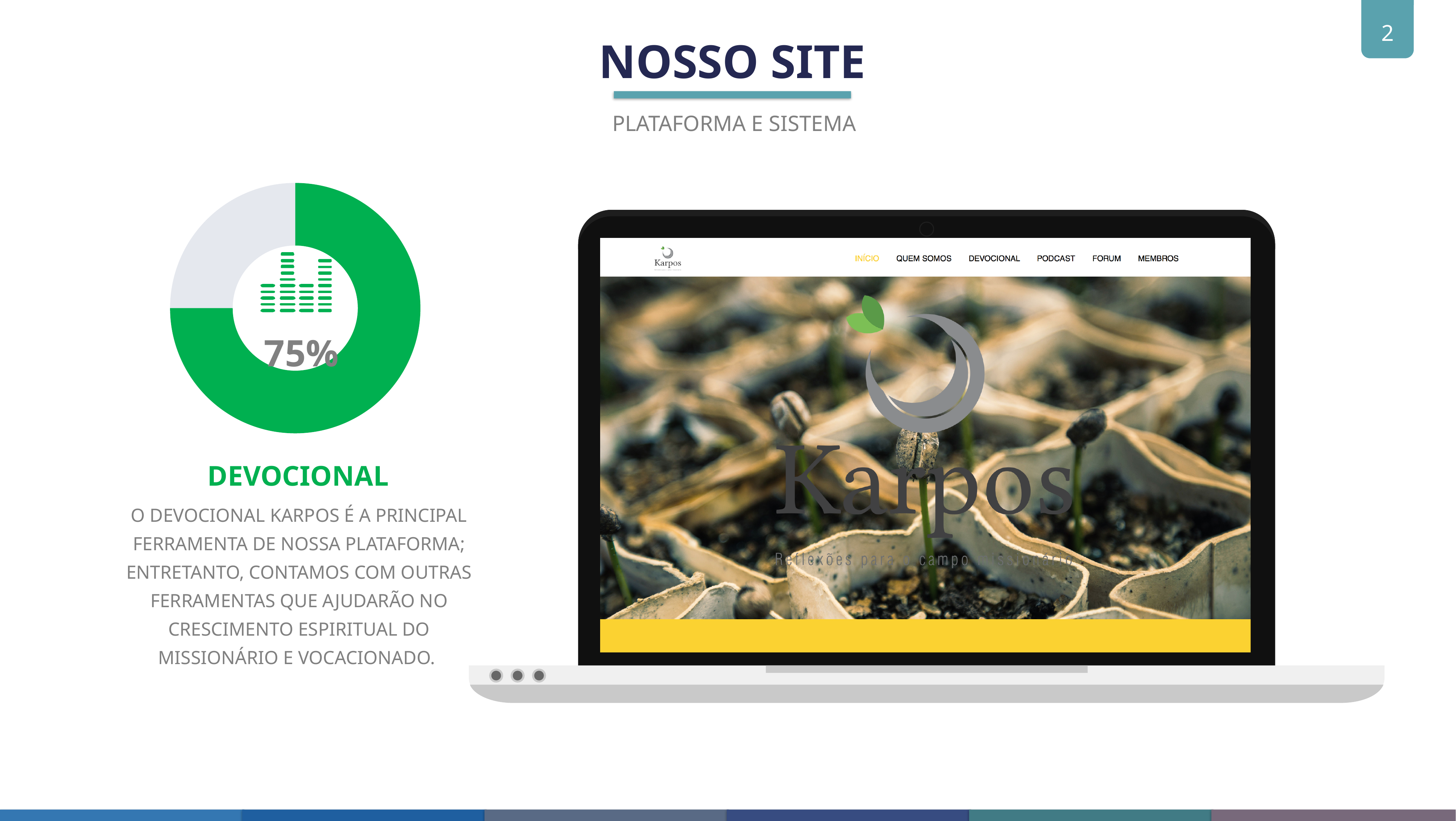
What share of the doughnut chart is filled in green? 75% What share of the doughnut chart is left unfilled (grey)? 25% What kind of chart is shown on the left of the slide? doughnut chart How many segments does the doughnut chart have? 2 What percentage is printed in the centre of the doughnut chart? 75% What colour is the filled portion of the doughnut chart? green What label appears directly below the doughnut chart? DEVOCIONAL Which segment of the doughnut chart is larger, the green one or the grey one? green Is the value shown in the doughnut chart greater or less than 50%? greater